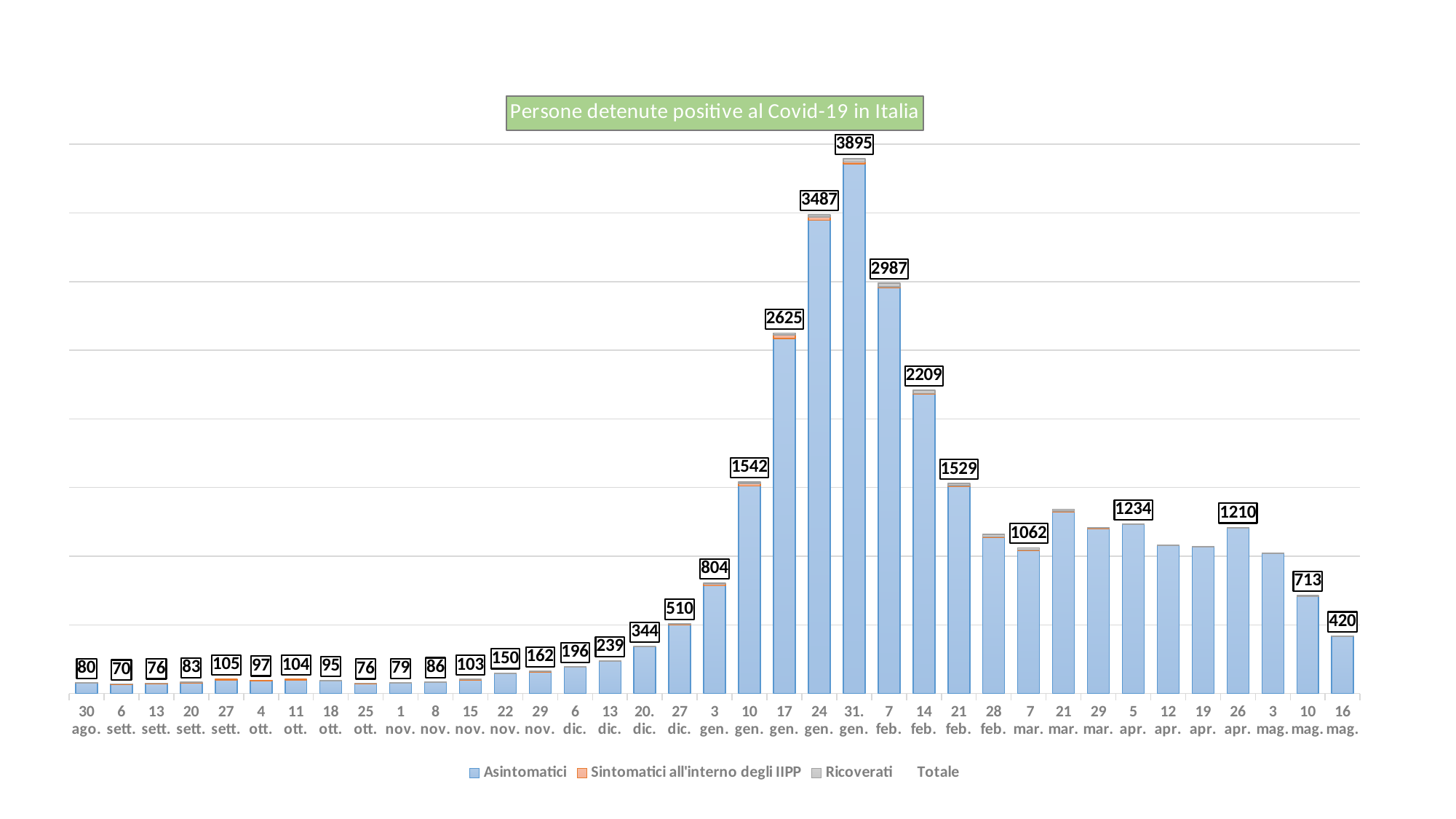
Which date has the lowest labelled total? 6 sett. What kind of chart is shown on the slide? Stacked bar chart How many series does the legend list? 4 What is the difference between the labelled totals for 31 gen. and 24 gen.? 408 Which date has the highest labelled total? 31 gen. Which is larger, the total for 5 apr. or the total for 10 mag.? 5 apr. How many dates are shown on the x axis? 37 What value is labelled for 3 gen.? 804 What is the total number of positive detainees shown for 31 gen.? 3895 What is the title of the chart? Persone detenute positive al Covid-19 in Italia What is the difference between the labelled totals for 7 feb. and 14 feb.? 778 What value is labelled for 16 mag.? 420